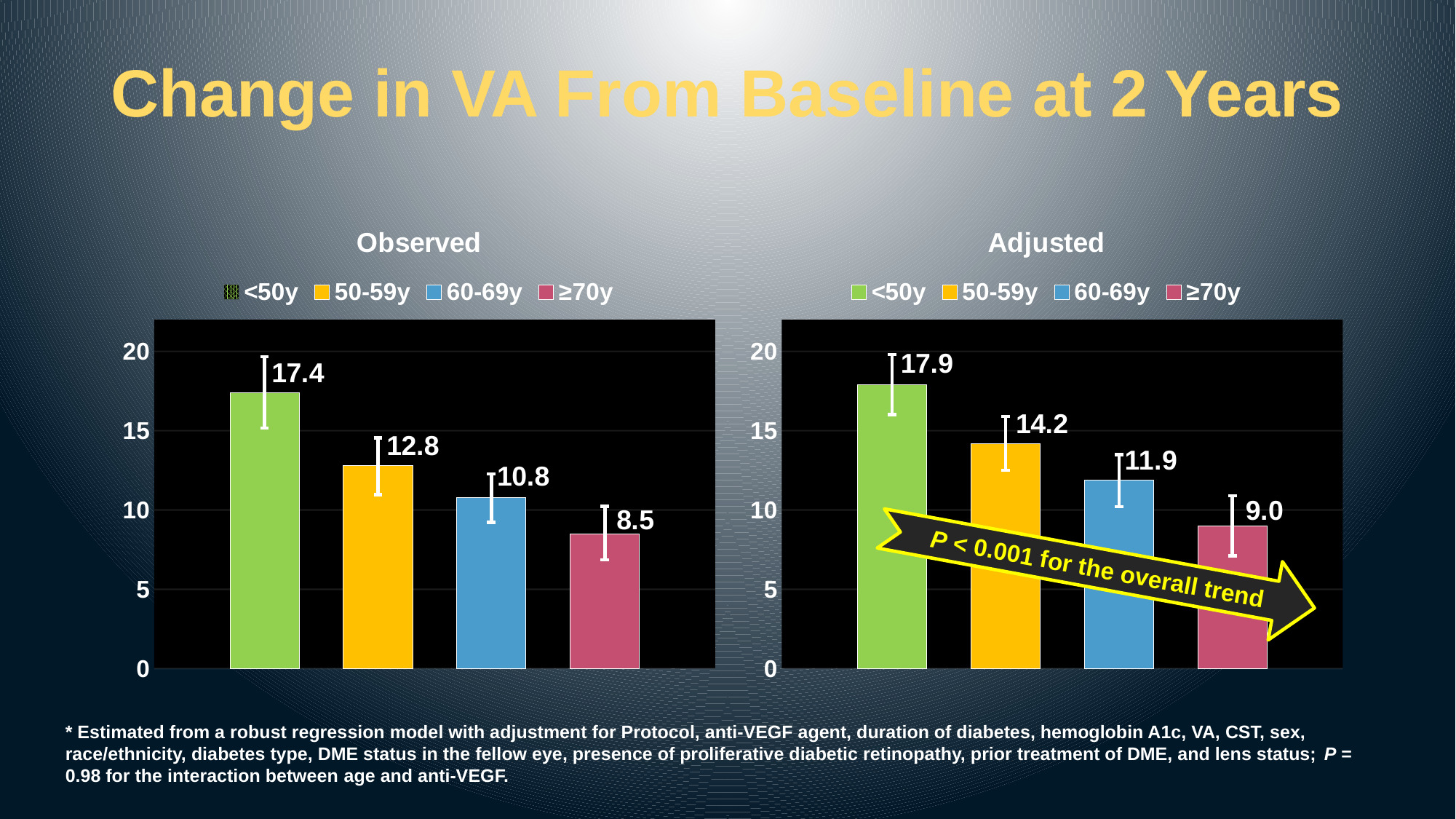
In the Observed chart, what is the value for the ≥70y group? 8.5 In the Observed chart, do the values rise or fall from the <50y group to the ≥70y group? fall In the Observed chart, what is the difference between the 60-69y and ≥70y values? 2.3 In the Adjusted chart, what is the value for the 60-69y group? 11.9 What kind of chart is the Adjusted chart? bar chart How many series does the legend of the Observed chart list? 4 In the Adjusted chart, which age group has the highest value? <50y In the Observed chart, what is the value for the <50y group? 17.4 In the Observed chart, which age group has the lowest value? ≥70y In the Adjusted chart, what is the difference between the <50y and 50-59y values? 3.7 In the Adjusted chart, is the value for ≥70y greater or less than 10? less Which is larger: the 50-59y value in the Observed chart or the 50-59y value in the Adjusted chart? Adjusted